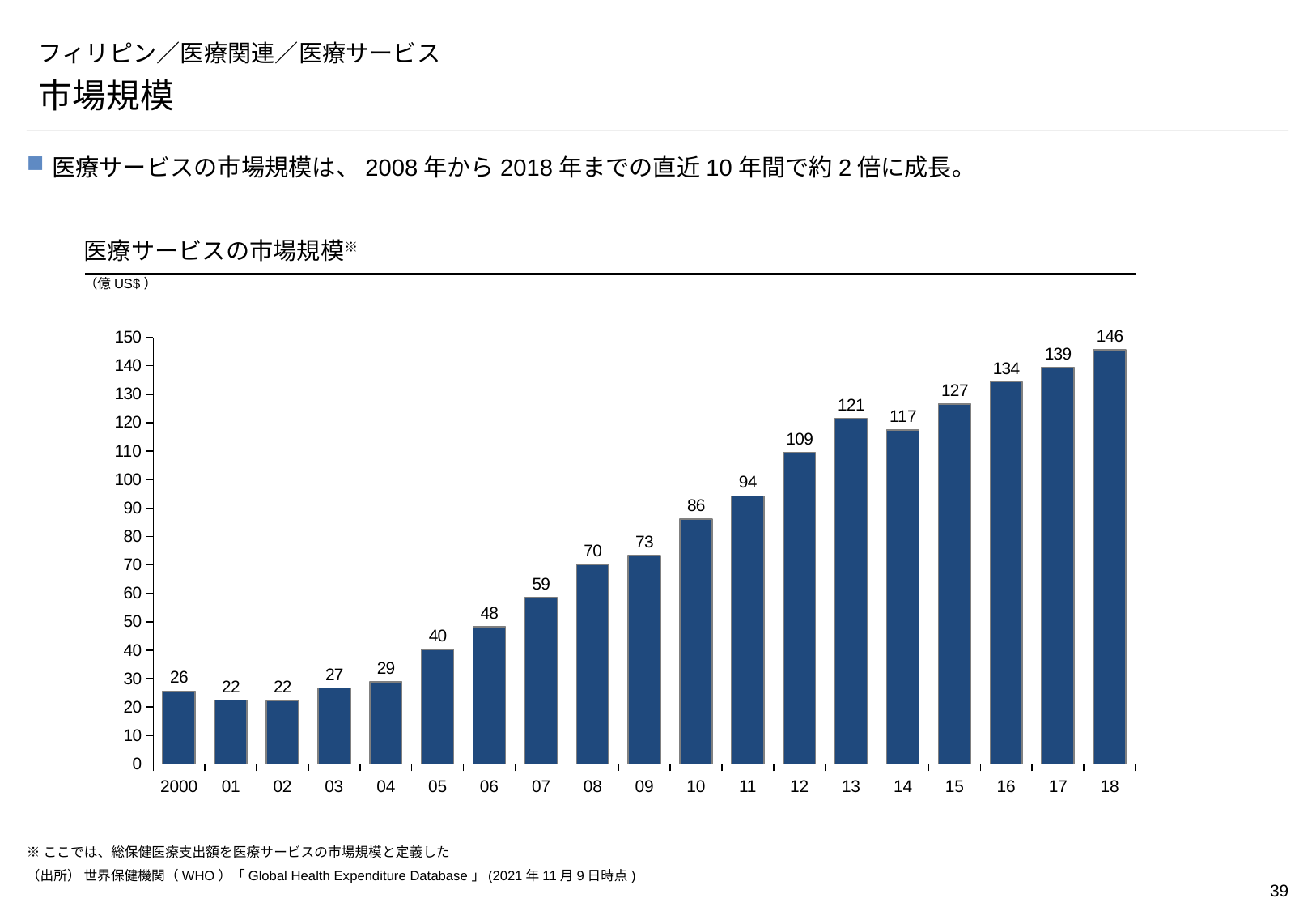
Which is larger, the value for 2013 or the value for 2014? 2013 What is the value for 2000? 26 How many years are shown on the x axis? 19 Is the value for 2012 greater or less than 100? greater What is the value for 2018? 146 What is the value for 2008? 70 Which year has the highest value? 18 What unit is shown for the y axis? 億US$ Do the values generally rise or fall from 2004 to 2013? rise What is the difference between the values for 2018 and 2008? 76 What kind of chart is this? bar chart What is the difference between the values for 2010 and 2009? 13